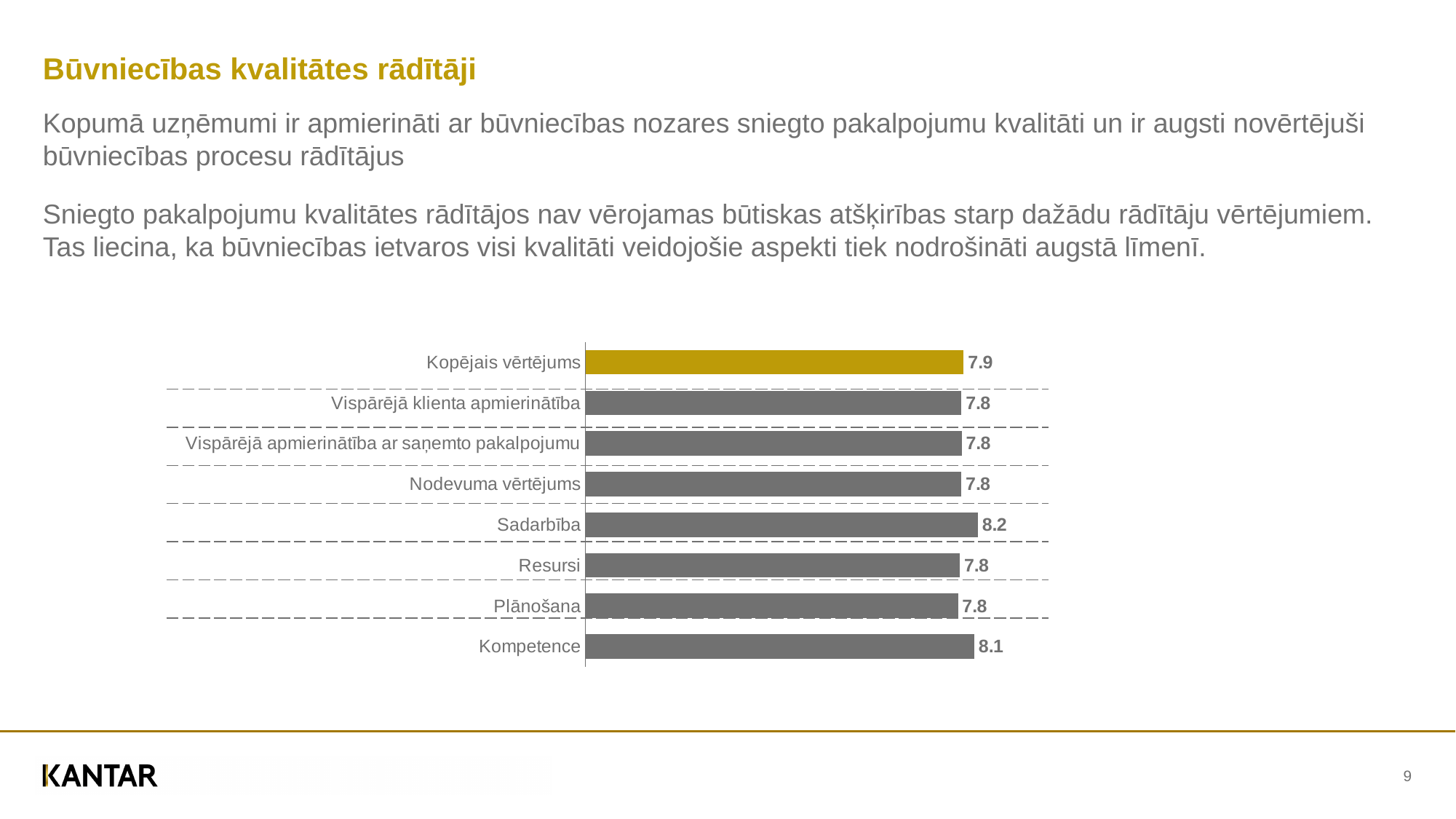
What is the value for Kopējais vērtējums? 7.9 How many categories are shown in the chart? 8 Which has a larger value, Sadarbība or Kompetence? Sadarbība What is the value for Nodevuma vērtējums? 7.8 What is the value for Plānošana? 7.8 What is the difference between the values for Kompetence and Kopējais vērtējums? 0.2 What kind of chart is shown on the slide? Bar chart Which category's bar is coloured differently (gold) from the others? Kopējais vērtējums Which category has the highest value? Sadarbība What is the value for Sadarbība? 8.2 What is the value for Kompetence? 8.1 What is the difference between the values for Sadarbība and Resursi? 0.4